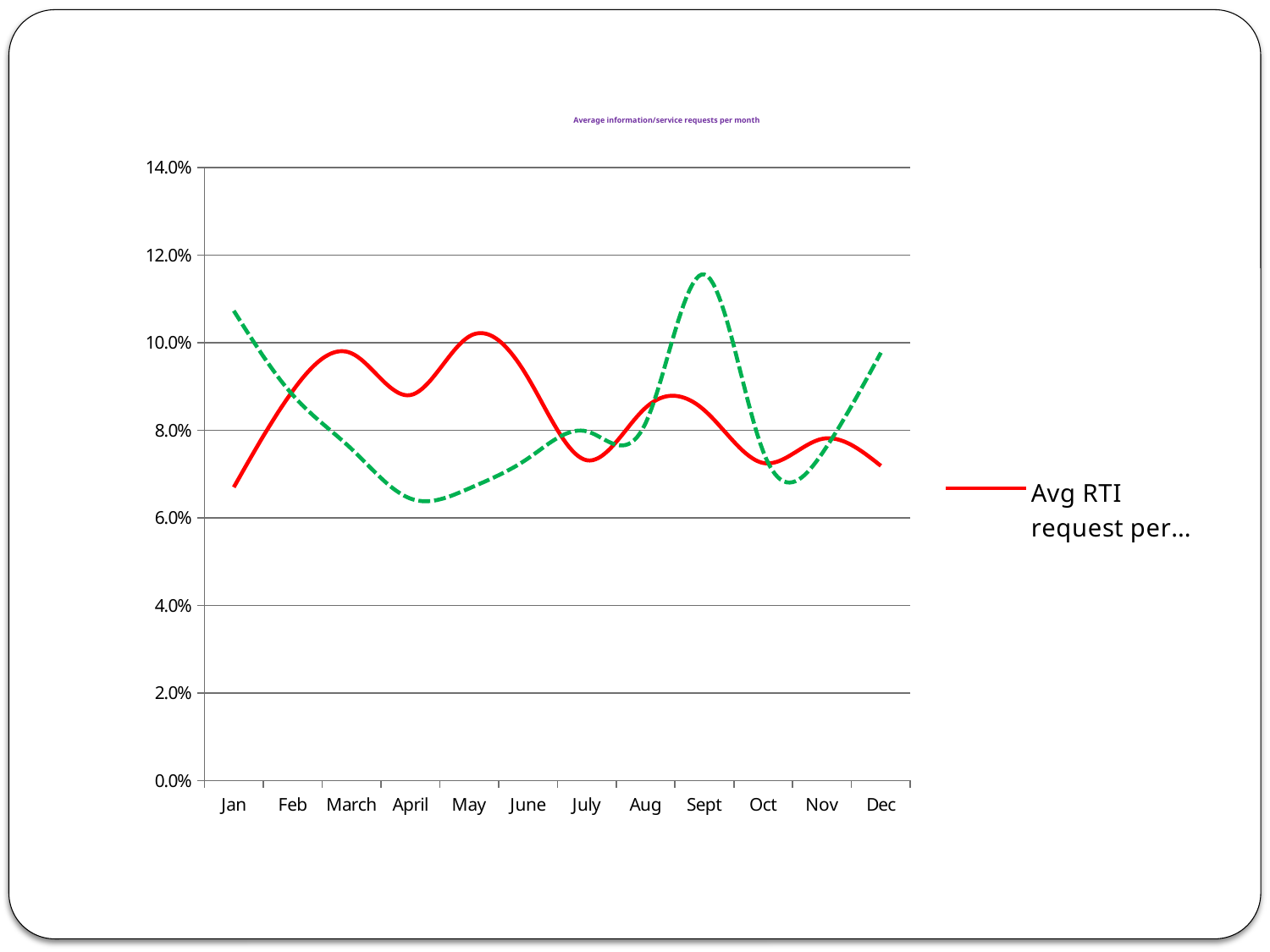
What colour is the solid line for the 'Avg RTI request per…' series? red In which month does the red solid line reach its highest value? May What is the title of the chart? Average information/service requests per month Does the red solid line rise or fall from Jan to March? rise In which month does the green dashed line reach its highest value? Sept What kind of chart is shown on the slide? line chart Is the value of the green dashed line in April greater or less than 8.0%? less How many series does the legend list? 1 How many months are shown along the x axis? 12 In which month is the red solid line at its lowest value? Jan Is the value of the red solid line in May greater or less than 10.0%? greater In Sept, which line has the higher value, the red solid line or the green dashed line? green dashed line